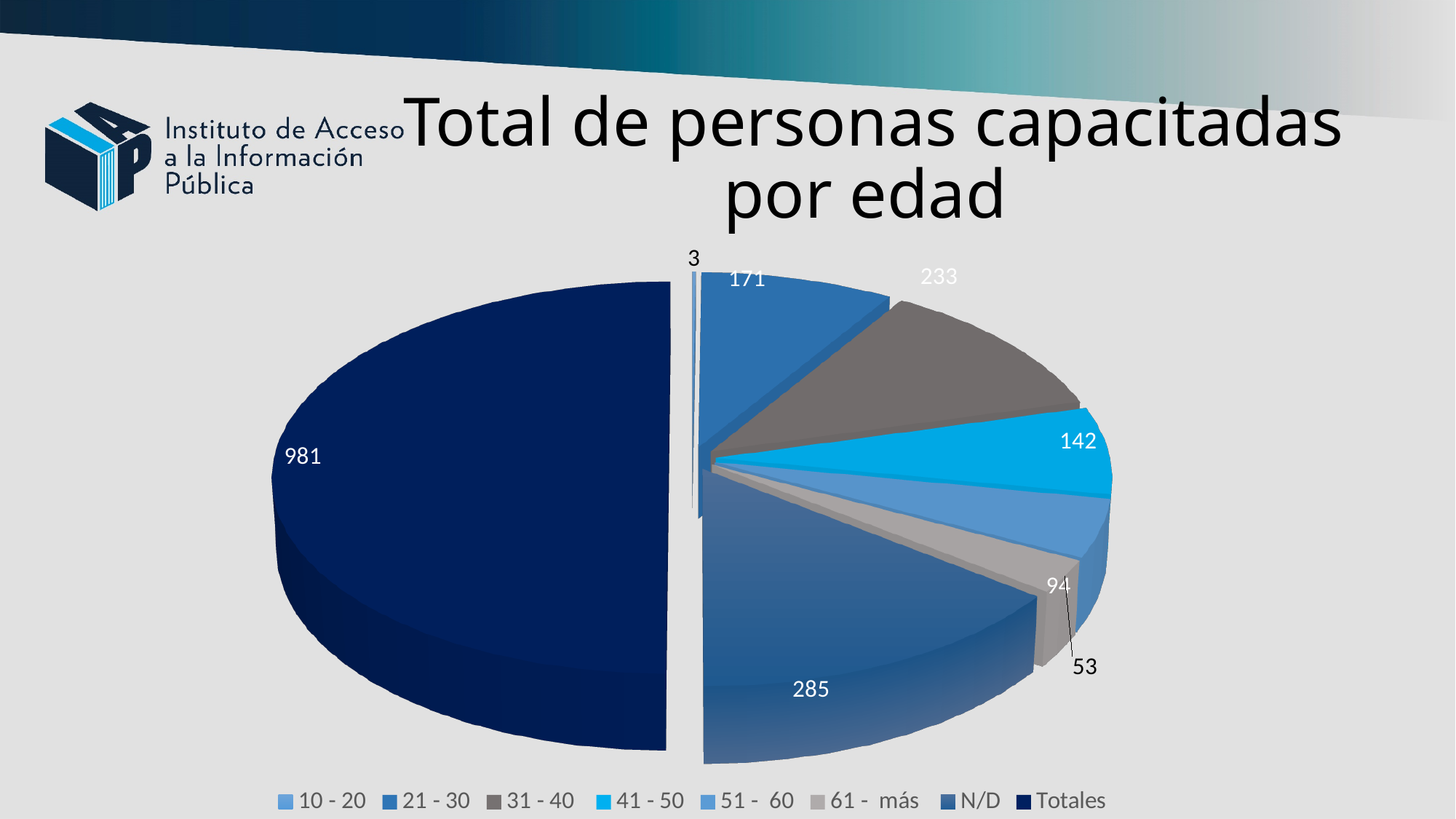
What is the value for the 41 - 50 age group? 142 What is the title of the chart? Total de personas capacitadas por edad What is the value for the 31 - 40 age group? 233 What is the value for the N/D category? 285 What type of chart is shown on the slide? pie chart Which category has the largest slice in the pie? Totales What is the difference between the values for 31 - 40 and 21 - 30? 62 What is the value for the 21 - 30 age group? 171 How many entries does the legend list? 8 Which category has the smallest slice in the pie? 10 - 20 What is the value shown for Totales? 981 Which is larger, the value for 51 - 60 or the value for 61 - más? 51 - 60